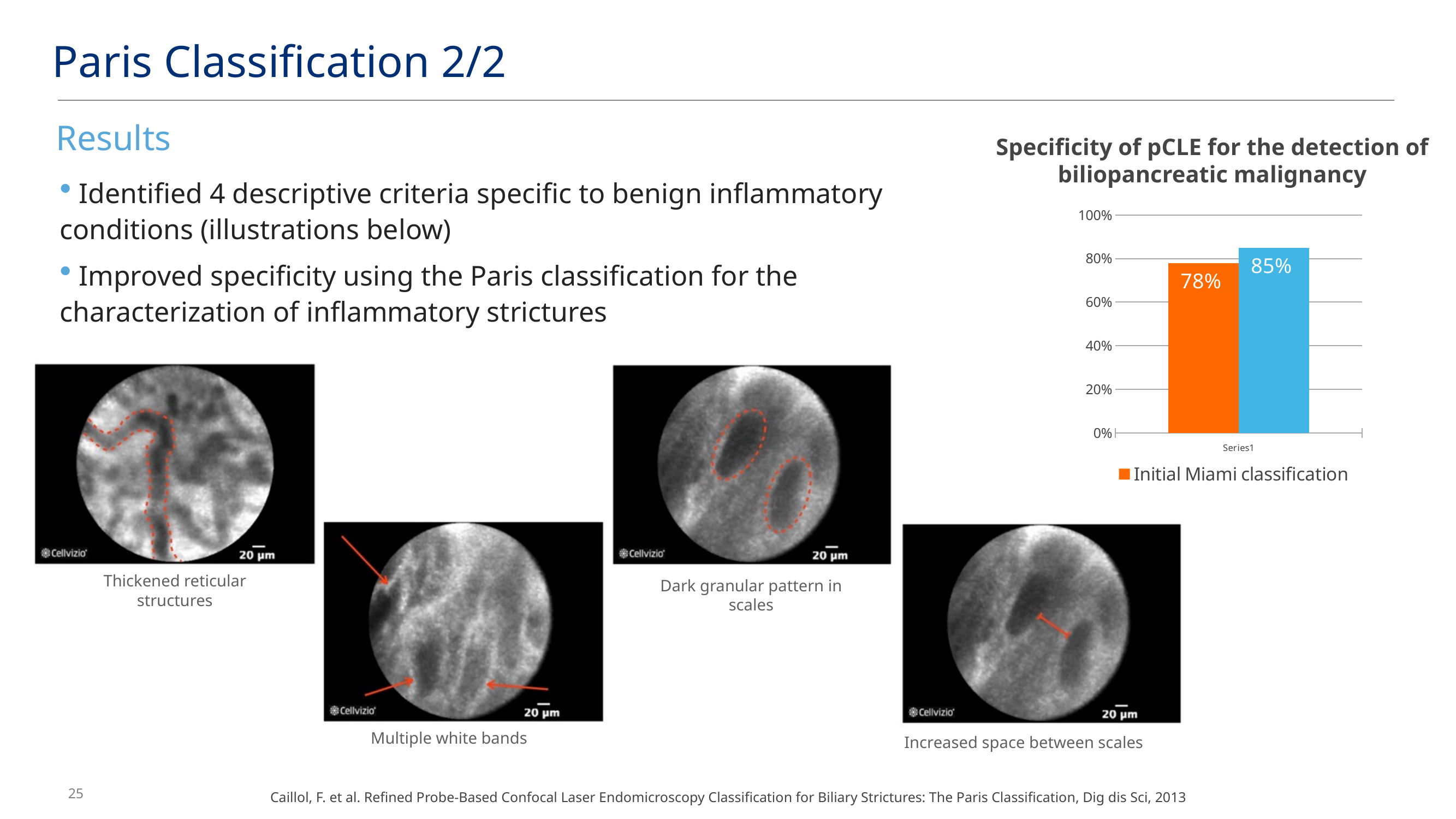
What is the difference between the blue bar's value and the Initial Miami classification value? 7% Which bar is taller, the orange Initial Miami classification bar or the blue bar? the blue bar What is the highest value shown on the chart's vertical axis? 100% What value is printed on the blue bar? 85% How many bars are plotted in the chart? 2 How many entries does the chart legend list? 1 What is the title of the chart? Specificity of pCLE for the detection of biliopancreatic malignancy Is the value for Initial Miami classification greater or less than 80%? less What colour is the Initial Miami classification bar? orange What kind of chart is shown on the slide? bar chart What is the value of the Initial Miami classification bar? 78% Is the value of the blue bar greater or less than 80%? greater